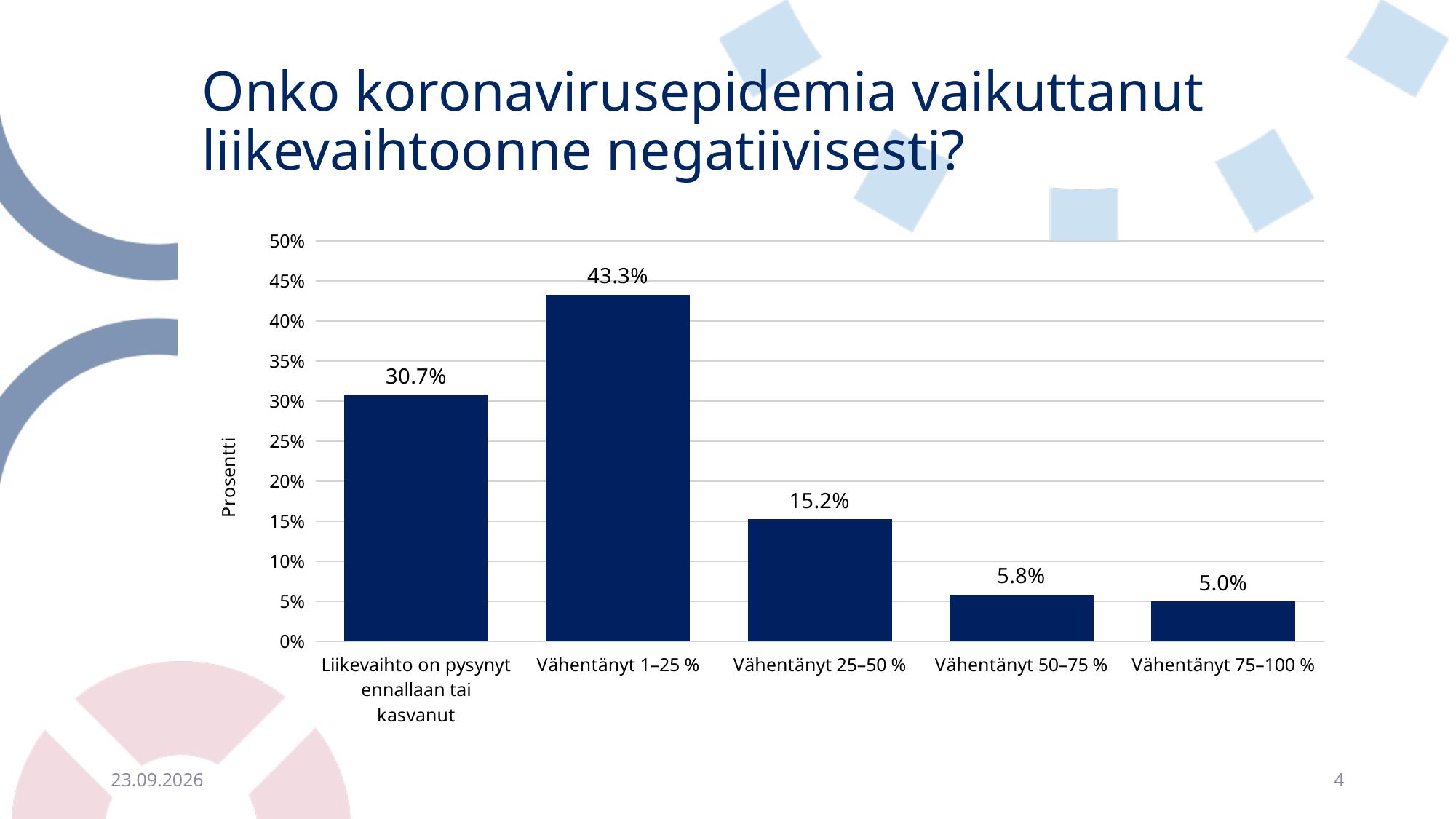
Which is larger, the value for "Vähentänyt 25–50 %" or the value for "Vähentänyt 50–75 %"? Vähentänyt 25–50 % What is the value for "Vähentänyt 75–100 %"? 5.0% What kind of chart is shown on the slide? bar chart What is the difference between the values for "Vähentänyt 1–25 %" and "Liikevaihto on pysynyt ennallaan tai kasvanut"? 12.6% How many categories are shown on the x axis? 5 Is the value for "Vähentänyt 25–50 %" greater or less than 20%? less What is the difference between the values for "Vähentänyt 25–50 %" and "Vähentänyt 50–75 %"? 9.4% What is the value for "Liikevaihto on pysynyt ennallaan tai kasvanut"? 30.7% Which category has the lowest value? Vähentänyt 75–100 % Which category has the highest value? Vähentänyt 1–25 % What is the value for "Vähentänyt 1–25 %"? 43.3% What is the label of the vertical axis? Prosentti